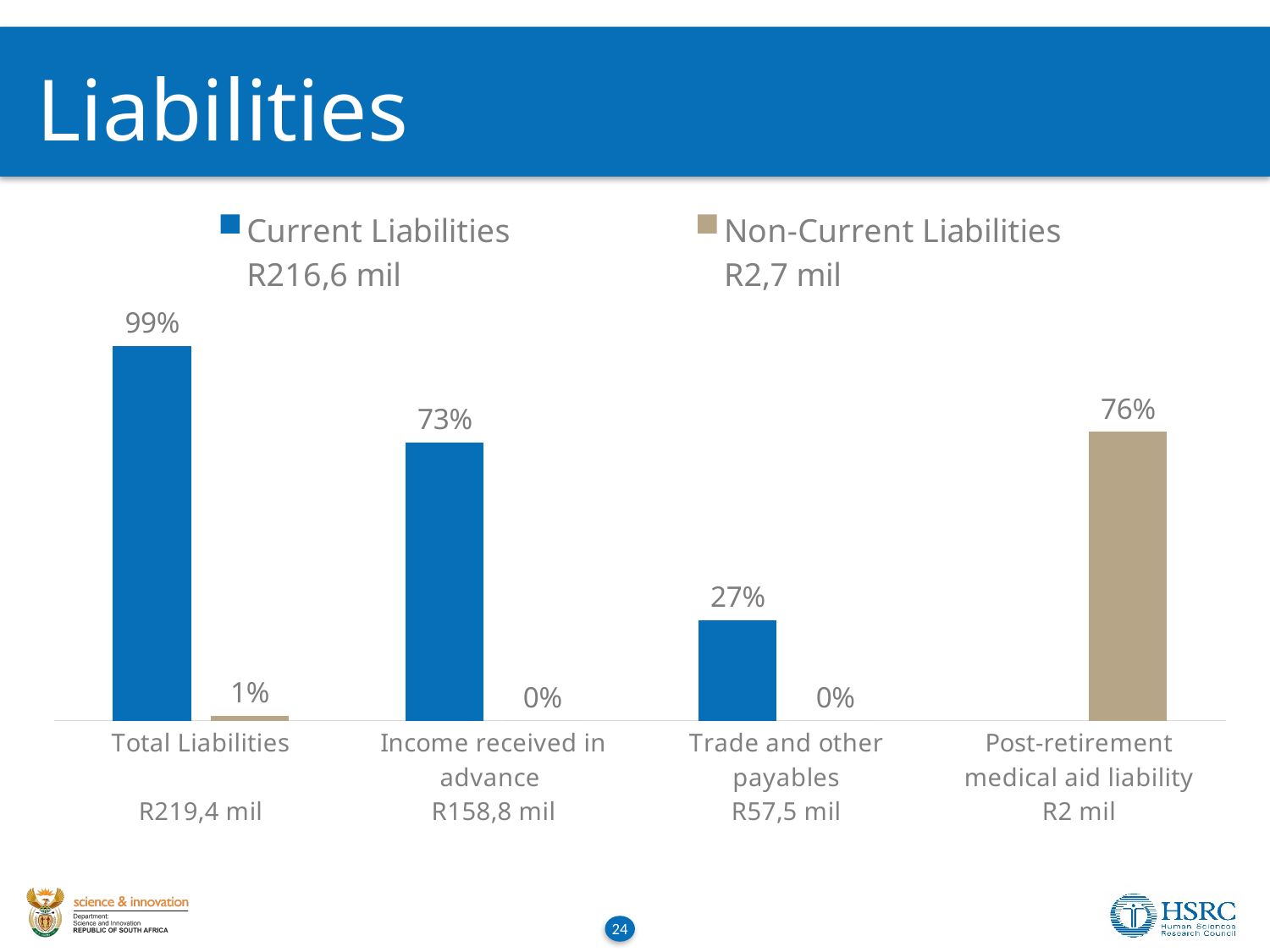
What is the Current Liabilities value for Trade and other payables? 27% What is the Current Liabilities value for Income received in advance? 73% How many series does the legend list? 2 What is the Non-Current Liabilities value for Post-retirement medical aid liability? 76% Which category has the highest Current Liabilities value? Total Liabilities What is the difference between the Current Liabilities values for Income received in advance and Trade and other payables? 46% What is the Current Liabilities value for Total Liabilities? 99% What is the Non-Current Liabilities value for Total Liabilities? 1% What amount is shown in the legend next to Current Liabilities? R216,6 mil Which is larger: the Current Liabilities value for Income received in advance or the Non-Current Liabilities value for Post-retirement medical aid liability? Post-retirement medical aid liability (Non-Current Liabilities) How many categories are shown on the x axis? 4 What type of chart is shown on the slide? bar chart